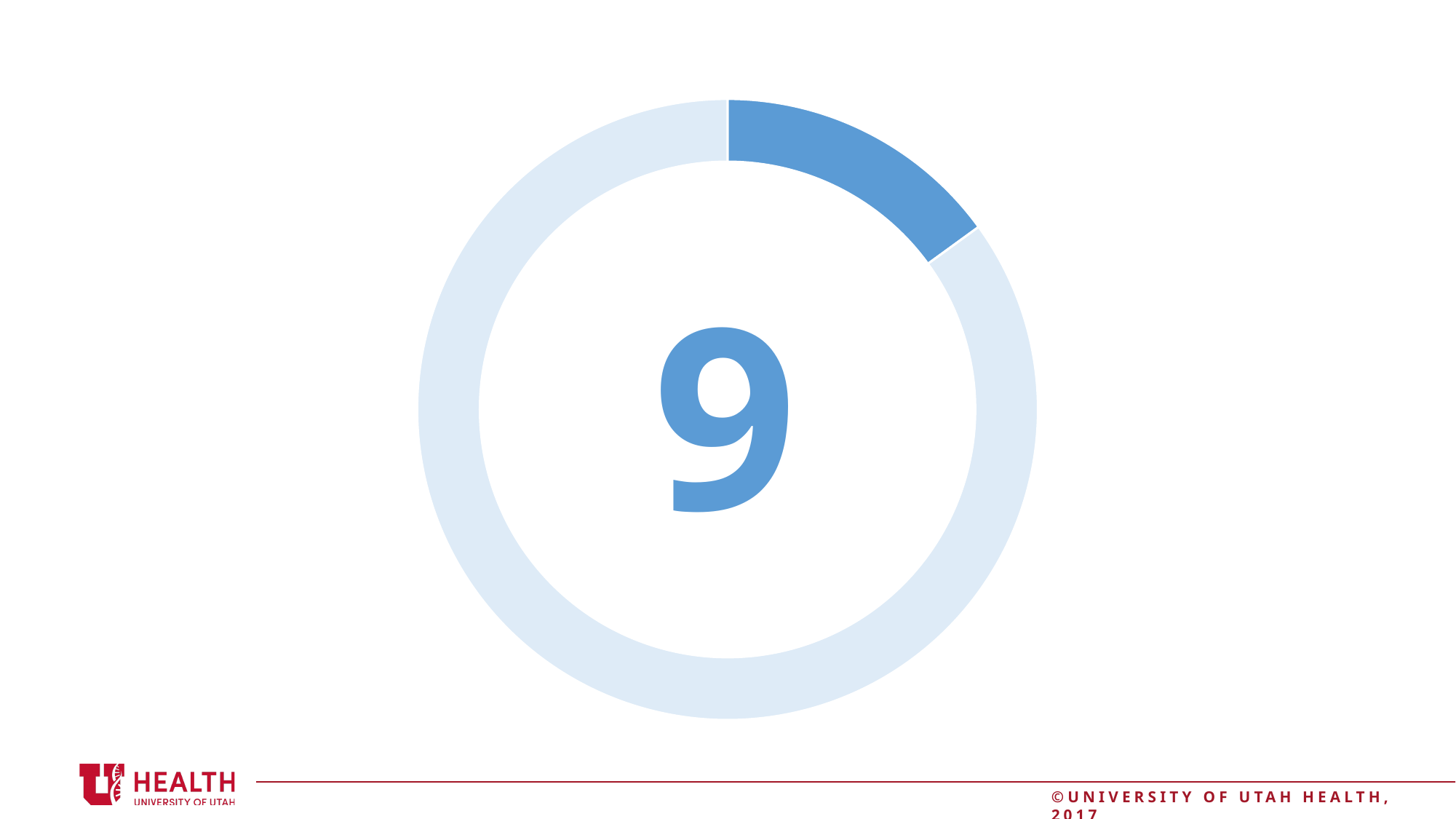
What colour is the smaller segment of the doughnut chart? Dark blue What kind of chart is shown on the slide? Doughnut chart How many segments does the doughnut chart have? 2 Which segment of the doughnut chart is larger, the dark blue one or the light blue one? The light blue one What number is displayed in the centre of the doughnut chart? 9 Is the dark blue segment's share of the doughnut chart greater or less than 50%? less